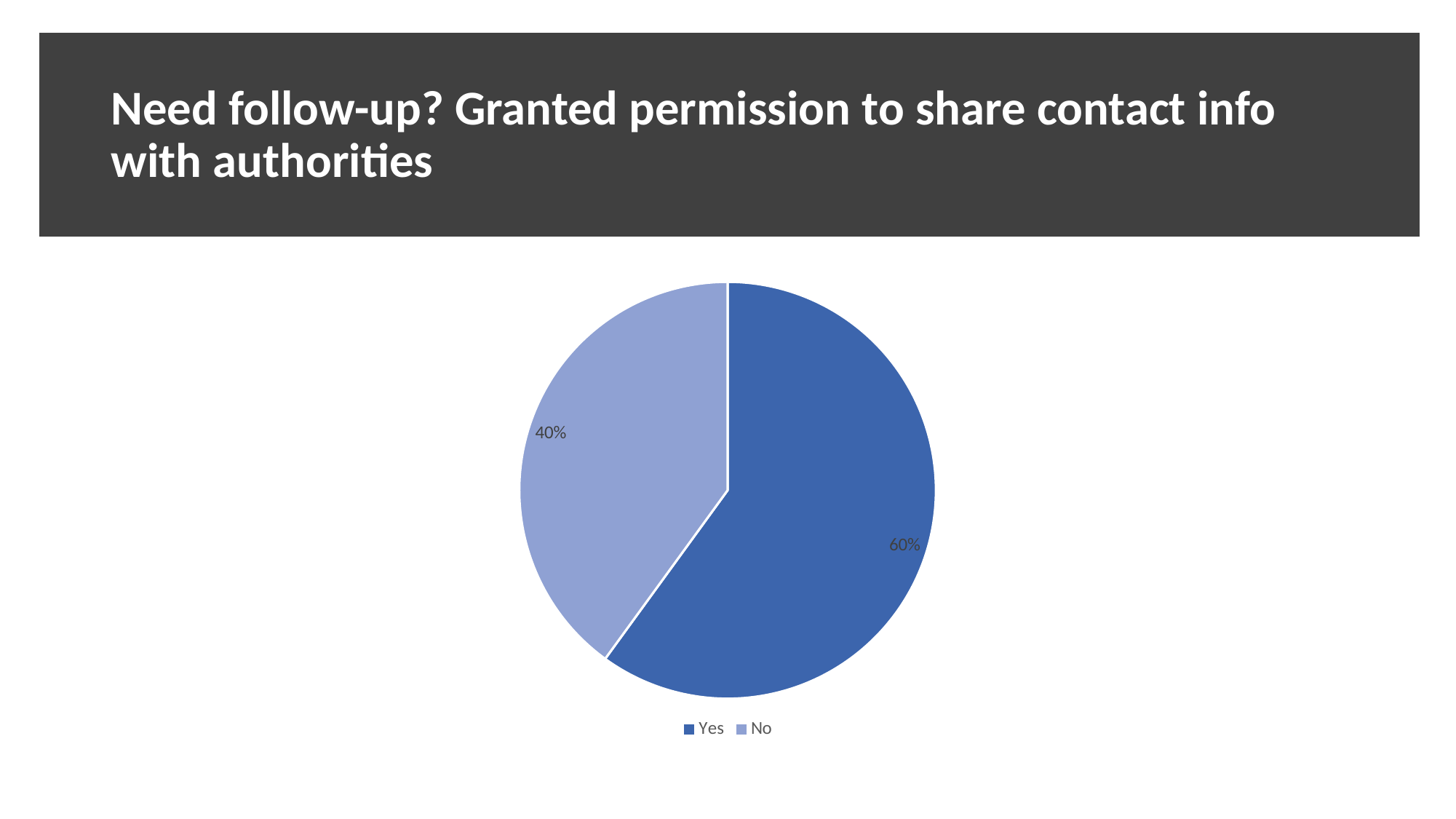
What share of the pie does the "No" slice represent? 40% Which legend entry is shown in the darker blue colour? Yes What kind of chart is shown on the slide? pie chart What is the title of the slide containing the chart? Need follow-up? Granted permission to share contact info with authorities How many entries does the legend list? 2 Which slice is the smallest? No What percentage of the pie is labelled "No"? 40% What is the difference in percentage points between the "Yes" and "No" slices? 20 Which slice is the largest? Yes What percentage of the pie is labelled "Yes"? 60% Which slice is larger, "Yes" or "No"? Yes How many slices does the pie chart have? 2